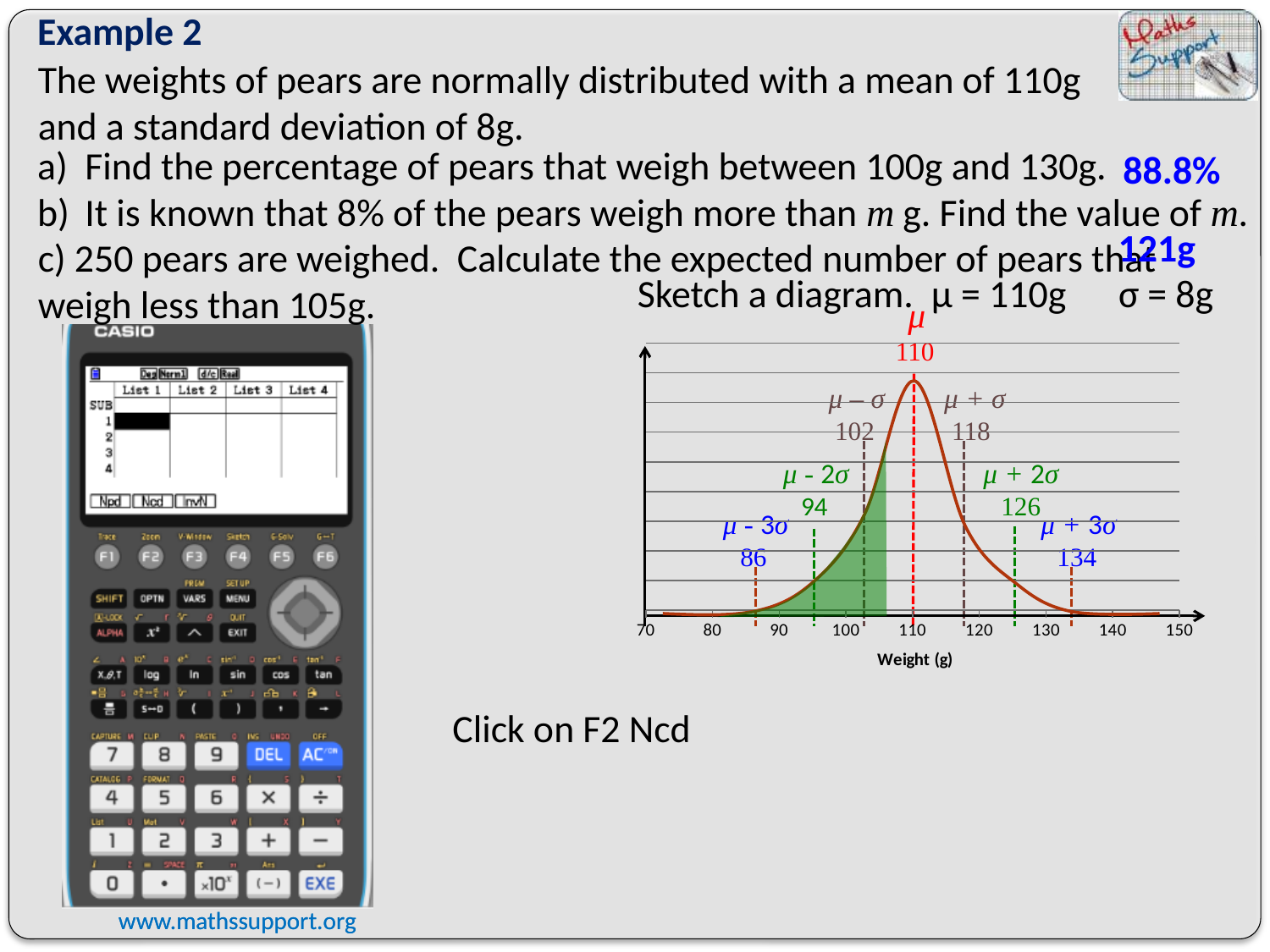
What value is marked at μ − 2σ on the chart? 94 What value is marked at the mean μ on the chart? 110 What value is marked at μ + 3σ on the chart? 134 What value is marked at μ + 2σ on the chart? 126 What are the lowest and highest tick values on the x axis of the chart? 70 and 150 How many labelled weight values (μ and the σ markers) are shown on the curve? 7 At which weight does the curve reach its peak? 110 What value is marked at μ − 3σ on the chart? 86 What is the label on the x axis of the chart? Weight (g) What value is marked at μ + σ on the chart? 118 What is the difference between the values marked at μ + σ and μ − σ on the chart? 16 What value is marked at μ − σ on the chart? 102